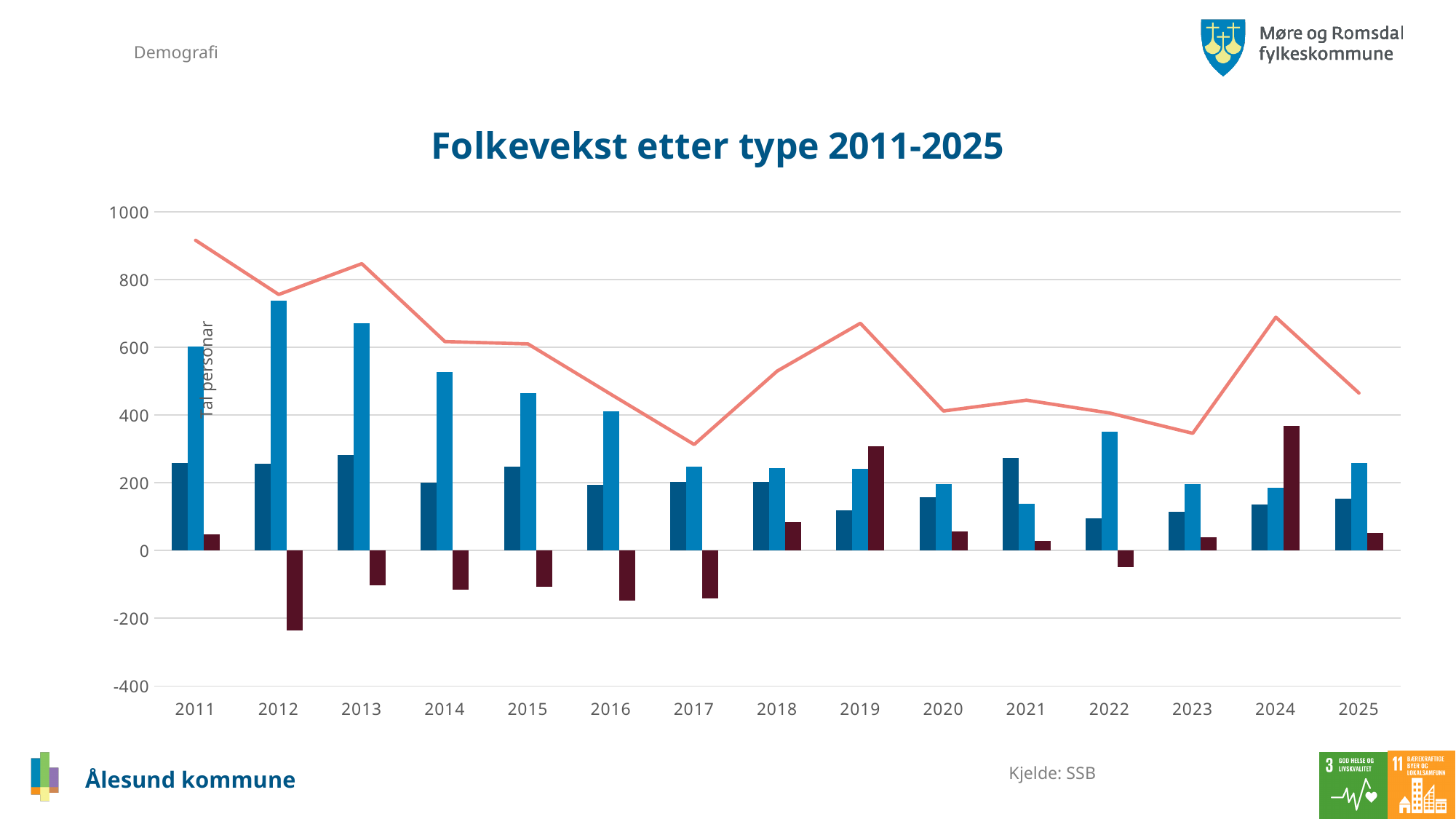
Is the value of the dark red bar for 2012 greater or less than -200? less In which year does the salmon line reach its highest value? 2011 Does the salmon line rise or fall from 2011 to 2017? fall In which year is the dark red bar the lowest (most negative)? 2012 How many years are shown along the x axis of the chart? 15 Is the value of the salmon line for 2011 greater or less than 800? greater Which year has the larger light blue bar, 2011 or 2013? 2013 What is the title of the chart? Folkevekst etter type 2011-2025 Is the value of the light blue bar for 2012 greater or less than 600? greater What kind of chart is shown on the slide? A combined bar and line chart In which year is the light blue bar the highest? 2012